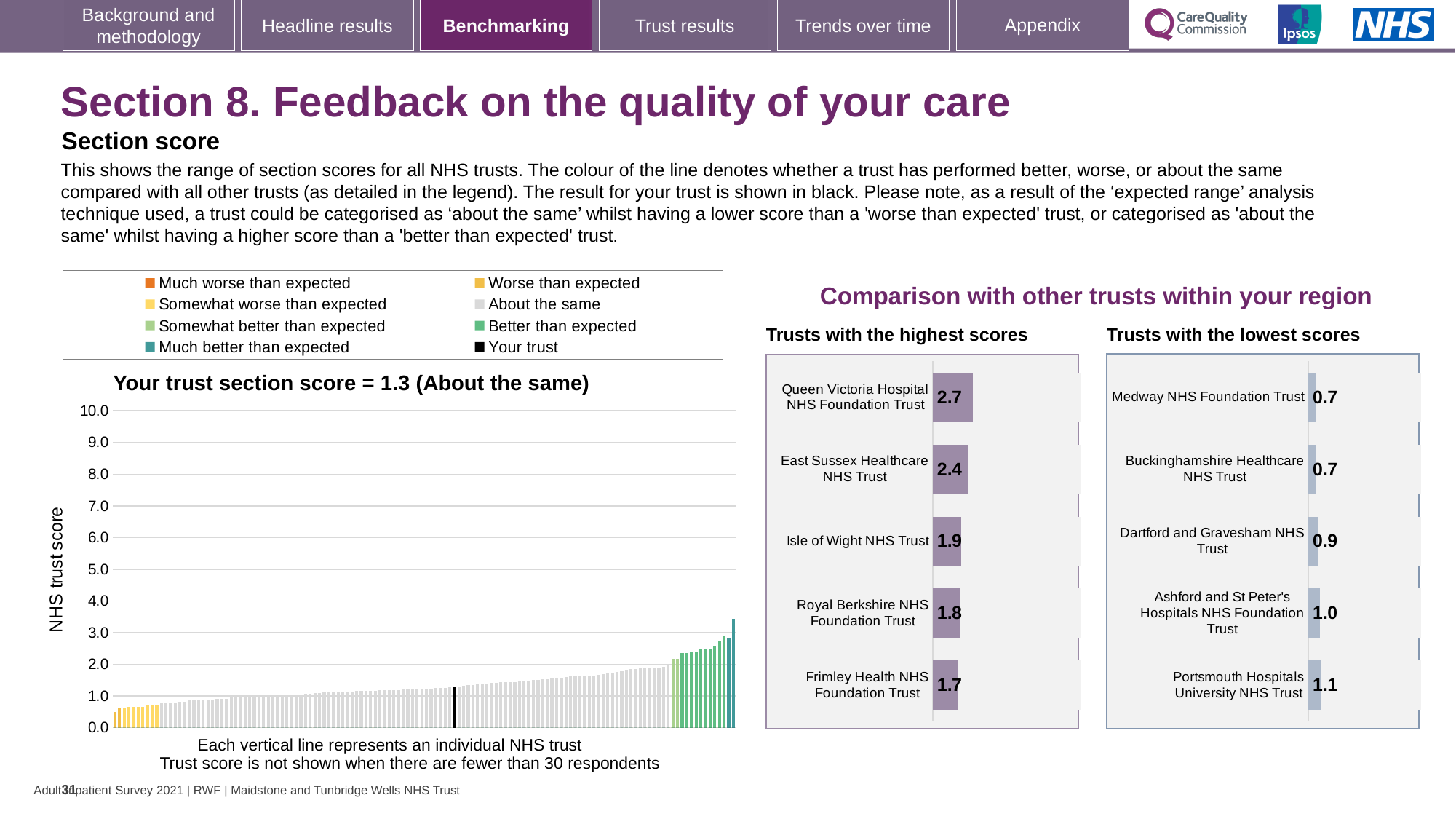
In the 'Trusts with the lowest scores' chart, what is the score for Dartford and Gravesham NHS Trust? 0.9 What kind of chart is the main chart on the left showing NHS trust scores? Bar chart In the 'Trusts with the lowest scores' chart, which trust has the highest score? Portsmouth Hospitals University NHS Trust How many entries does the legend above the main chart on the left list? 8 In the main chart on the left, is the value of the tallest bar greater or less than 3.0? greater In the main chart on the left, what is the section score for your trust? 1.3 In the 'Trusts with the highest scores' chart, what is the difference between the scores of Queen Victoria Hospital NHS Foundation Trust and Frimley Health NHS Foundation Trust? 1.0 In the 'Trusts with the highest scores' chart, which has the higher score: Isle of Wight NHS Trust or Royal Berkshire NHS Foundation Trust? Isle of Wight NHS Trust In the 'Trusts with the lowest scores' chart, what is the difference between the scores of Portsmouth Hospitals University NHS Trust and Medway NHS Foundation Trust? 0.4 In the 'Trusts with the highest scores' chart, what is the score for Queen Victoria Hospital NHS Foundation Trust? 2.7 In the 'Trusts with the highest scores' chart, which trust has the highest score? Queen Victoria Hospital NHS Foundation Trust How many trusts are shown in the 'Trusts with the highest scores' chart? 5